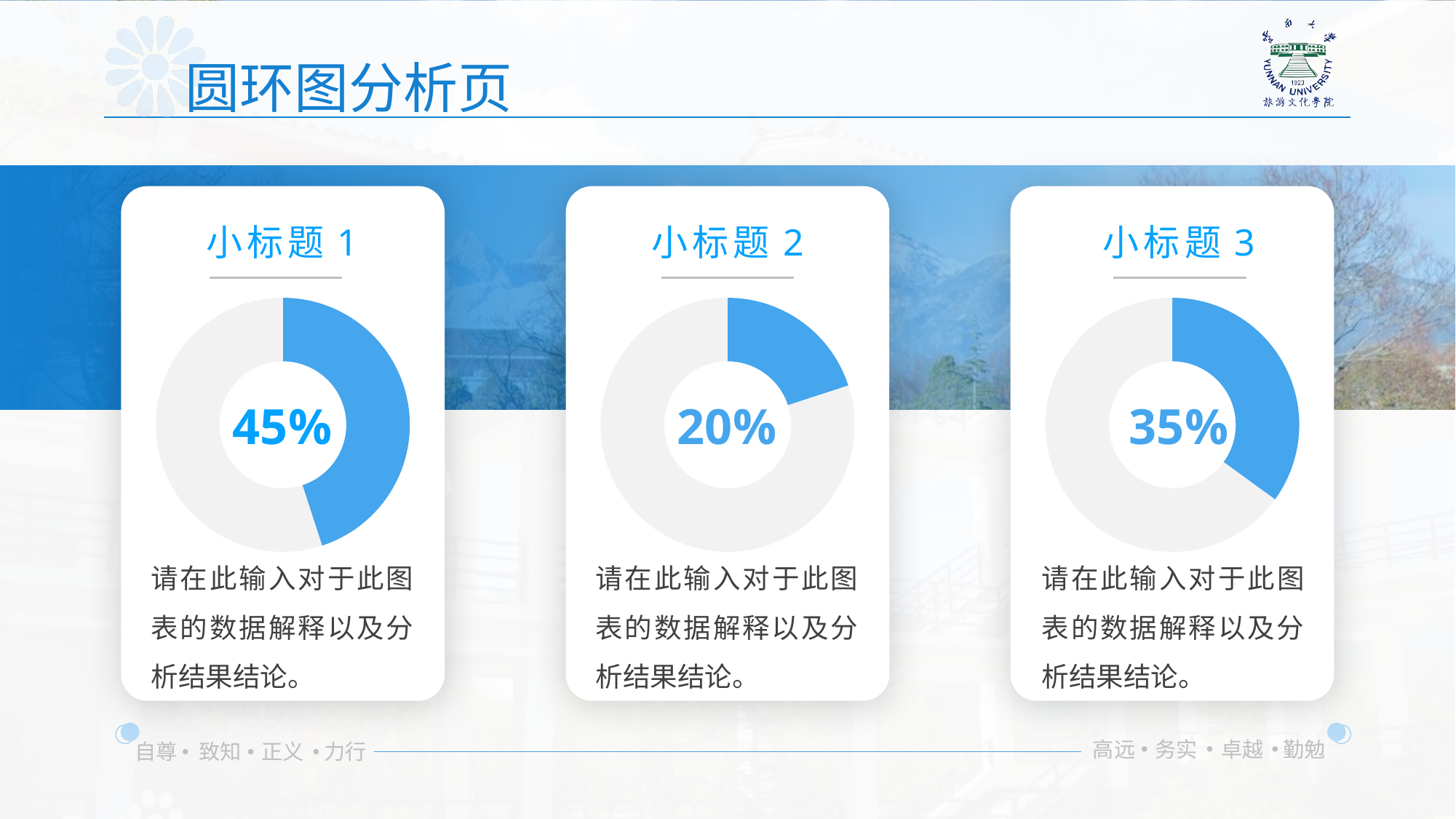
What type of chart is used under each of the three subtitles on this slide? Donut chart Which chart shows a larger percentage, 小标题 2 or 小标题 3? 小标题 3 Which of the three donut charts (小标题 1, 小标题 2, 小标题 3) shows the lowest percentage? 小标题 2 How many donut charts are shown on this slide? 3 What percentage is shown in the centre of the donut chart under 小标题 2? 20% Which of the three donut charts (小标题 1, 小标题 2, 小标题 3) shows the highest percentage? 小标题 1 What percentage is shown in the centre of the donut chart under 小标题 1? 45% Which chart shows a larger percentage, 小标题 1 or 小标题 3? 小标题 1 What is the title of this slide? 圆环图分析页 What percentage is shown in the centre of the donut chart under 小标题 3? 35% What is the difference between the percentage in the 小标题 3 chart and the percentage in the 小标题 2 chart? 15% What is the difference between the percentage in the 小标题 1 chart and the percentage in the 小标题 2 chart? 25%